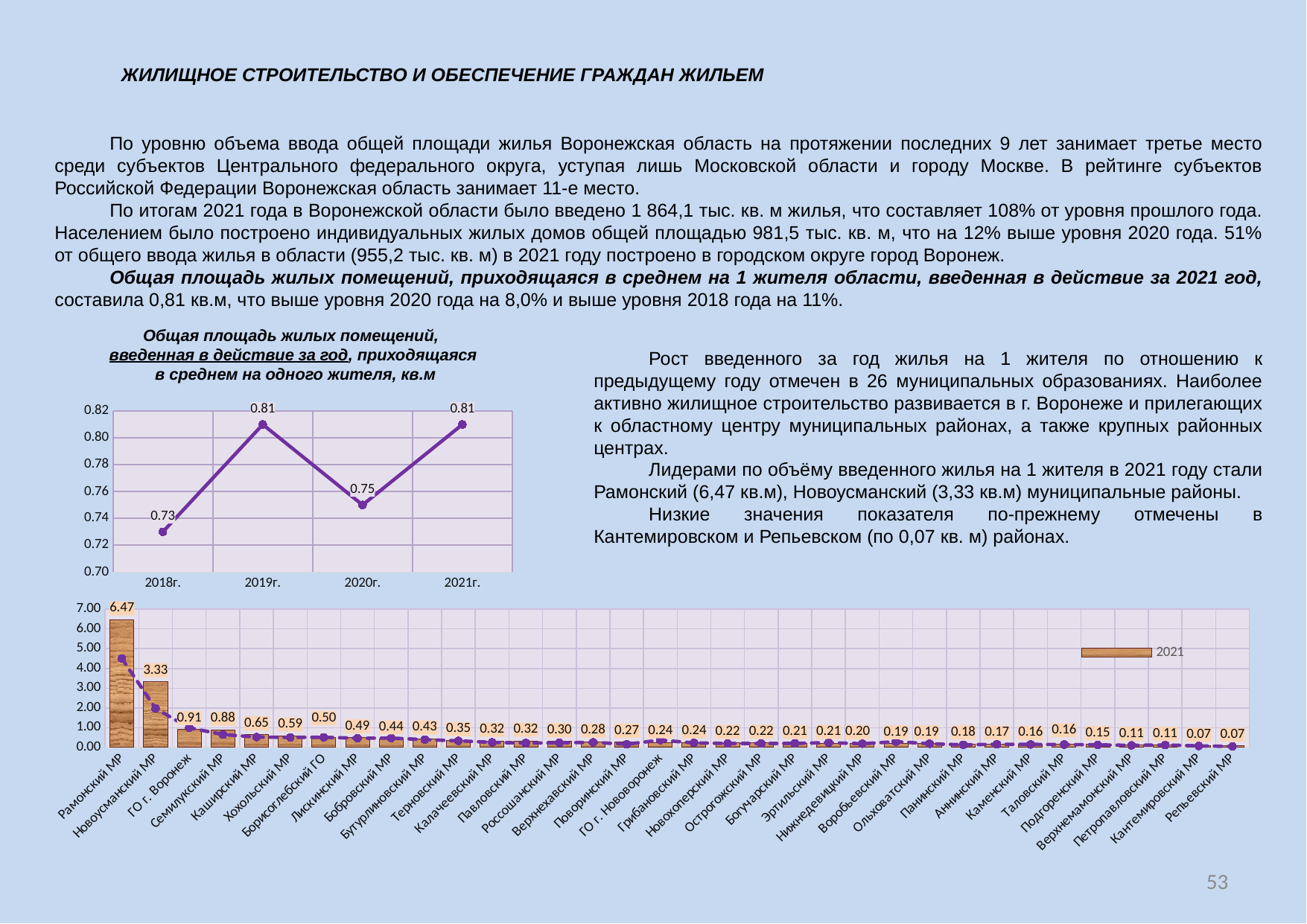
In the bar chart at the bottom, what is the value for Новоусманский МР? 3.33 In the bar chart at the bottom, what is the difference between Рамонский МР and Новоусманский МР? 3.14 In the line chart on the left, what is the difference between the 2019г. value and the 2018г. value? 0.08 In the line chart on the left, what is the value for 2018г.? 0.73 In the bar chart at the bottom, what year does the legend show? 2021 In the line chart on the left, what is the value for 2020г.? 0.75 In the line chart on the left, is the value for 2020г. greater or less than 0.76? less In the bar chart at the bottom, what is the value for ГО г. Воронеж? 0.91 In the line chart on the left, which year has the lowest value? 2018г. In the line chart on the left, how many years are plotted? 4 In the bar chart at the bottom, which is larger: Каширский МР or Хохольский МР? Каширский МР In the bar chart at the bottom, which category has the highest value? Рамонский МР